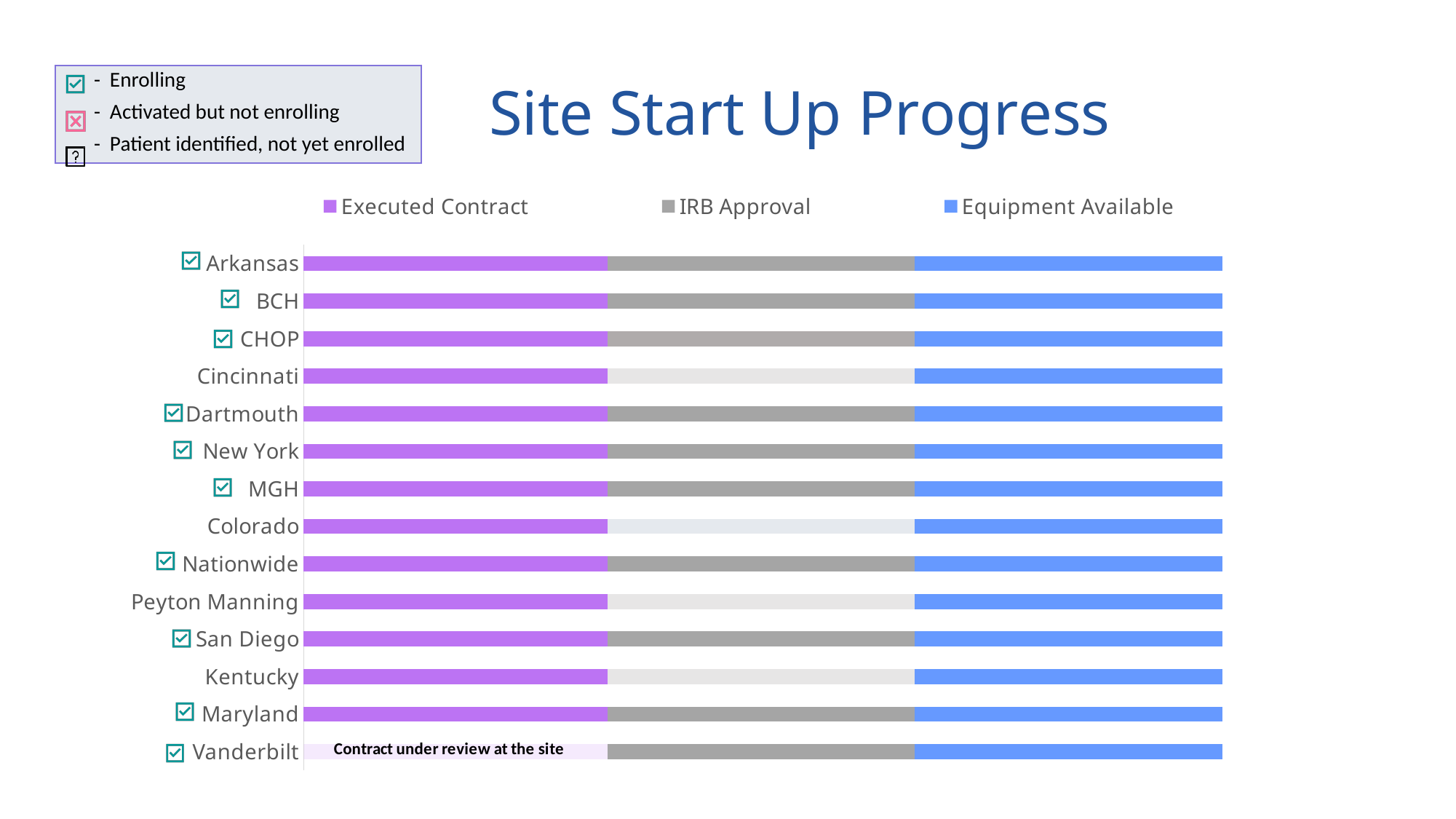
How many sites have a light gray (unfilled) IRB Approval segment instead of a dark gray one? 4 What are the three series named in the legend? Executed Contract, IRB Approval, Equipment Available How many sites are listed as categories in the chart? 14 Is the IRB Approval segment for Arkansas shown in dark gray or light gray? Dark gray Which sites have a light gray IRB Approval segment? Cincinnati, Colorado, Peyton Manning, Kentucky Is the IRB Approval segment for Kentucky shown in dark gray or light gray? Light gray How many sites have a check-mark icon next to their name in the chart? 10 Which site is listed first (at the top) of the chart? Arkansas How many series does the chart legend list? 3 What kind of chart is shown on the slide? Stacked bar chart What is the title of the slide's chart? Site Start Up Progress Which site's Executed Contract segment is replaced by the note "Contract under review at the site"? Vanderbilt